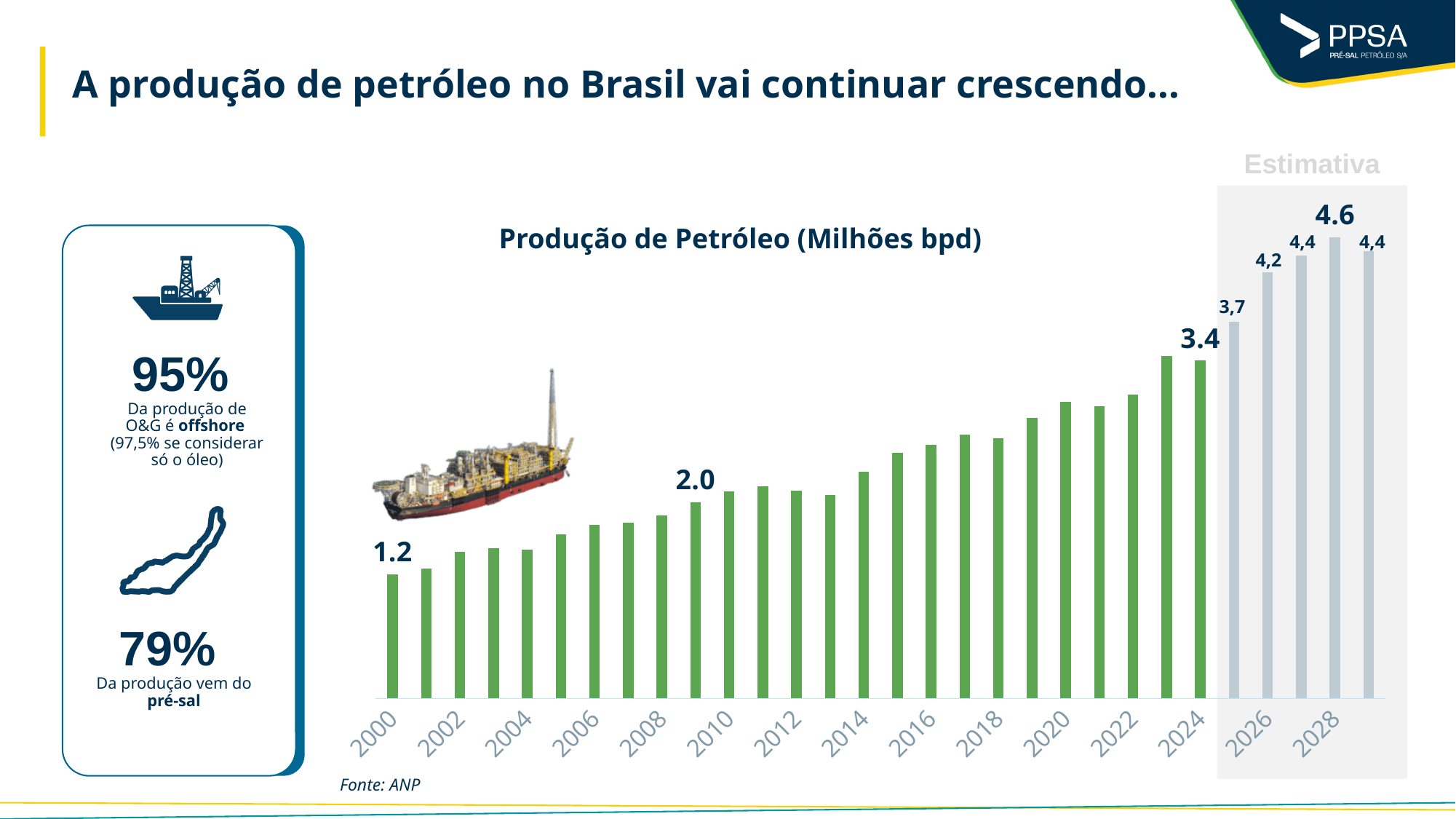
Which year has the lowest oil production value in the chart? 2000 What is the oil production value shown for 2000? 1.2 What is the estimated oil production value shown for 2028? 4.6 Which year has the highest oil production value in the chart? 2028 What is the estimated oil production value shown for 2026? 4,2 What type of chart is shown on the slide? bar chart What is the oil production value shown for 2024? 3.4 What is the difference between the oil production values for 2024 and 2000? 2.2 Which is larger, the estimated value for 2027 or for 2025? 2027 What is the title of the chart? Produção de Petróleo (Milhões bpd) How many bars are plotted in the chart? 30 Do the oil production values generally rise or fall from 2000 to 2028? rise